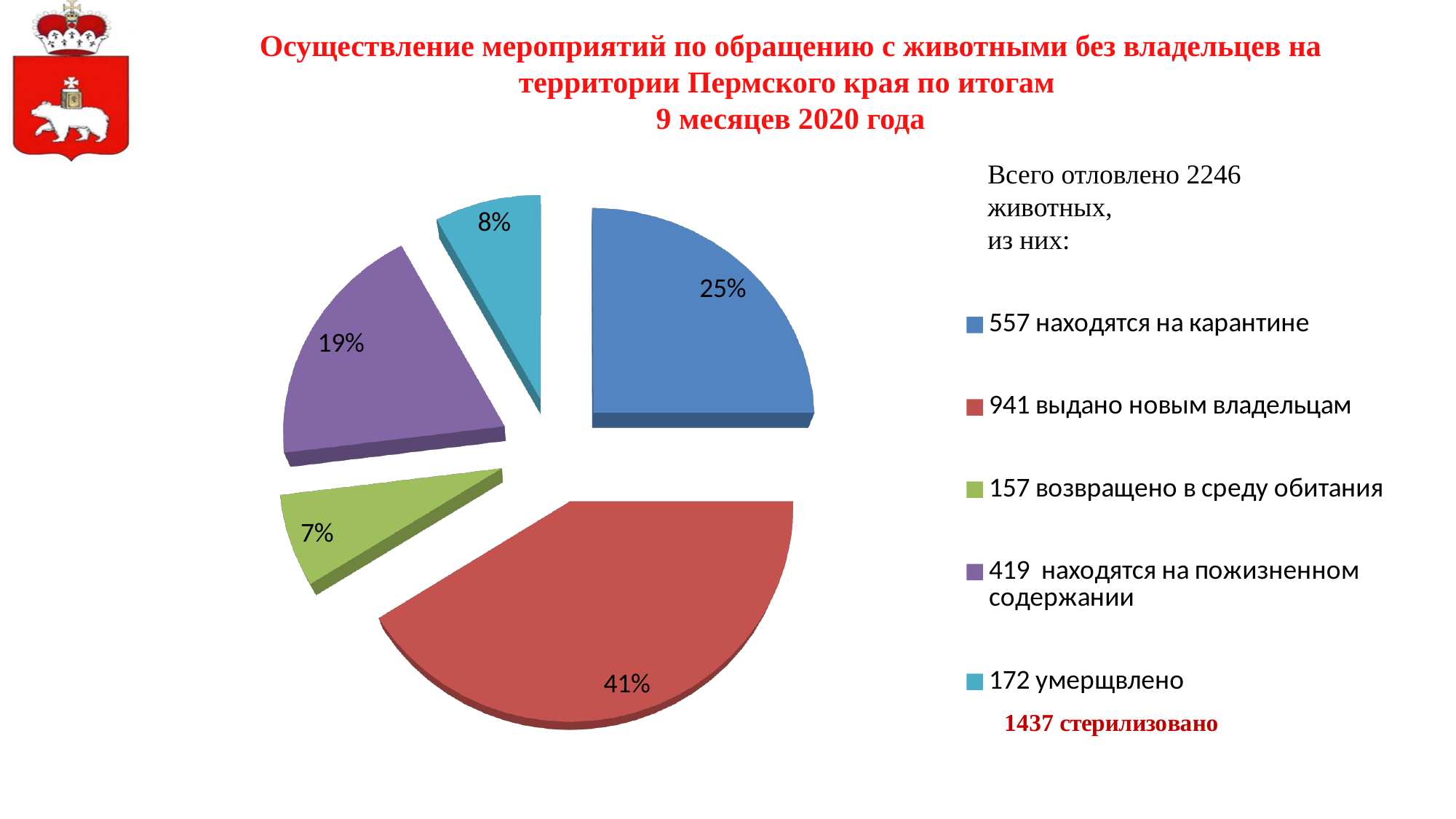
Which category has the largest slice of the pie? выдано новым владельцам According to the legend, how many animals are "возвращено в среду обитания"? 157 How many slices does the pie chart have? 5 Which slice is larger: "находятся на карантине" or "находятся на пожизненном содержании"? находятся на карантине Which category has the smallest slice of the pie? возвращено в среду обитания What kind of chart is shown on the slide? Pie chart What is the difference in percentage points between the "выдано новым владельцам" slice and the "находятся на карантине" slice? 16 percentage points What share of the pie does the slice for "выдано новым владельцам" (red) represent? 41% What colour is the slice for "умерщвлено" in the pie chart? Cyan (light blue) What share of the pie does the slice for "умерщвлено" (cyan) represent? 8% What share of the pie does the slice for "находятся на карантине" (blue) represent? 25%